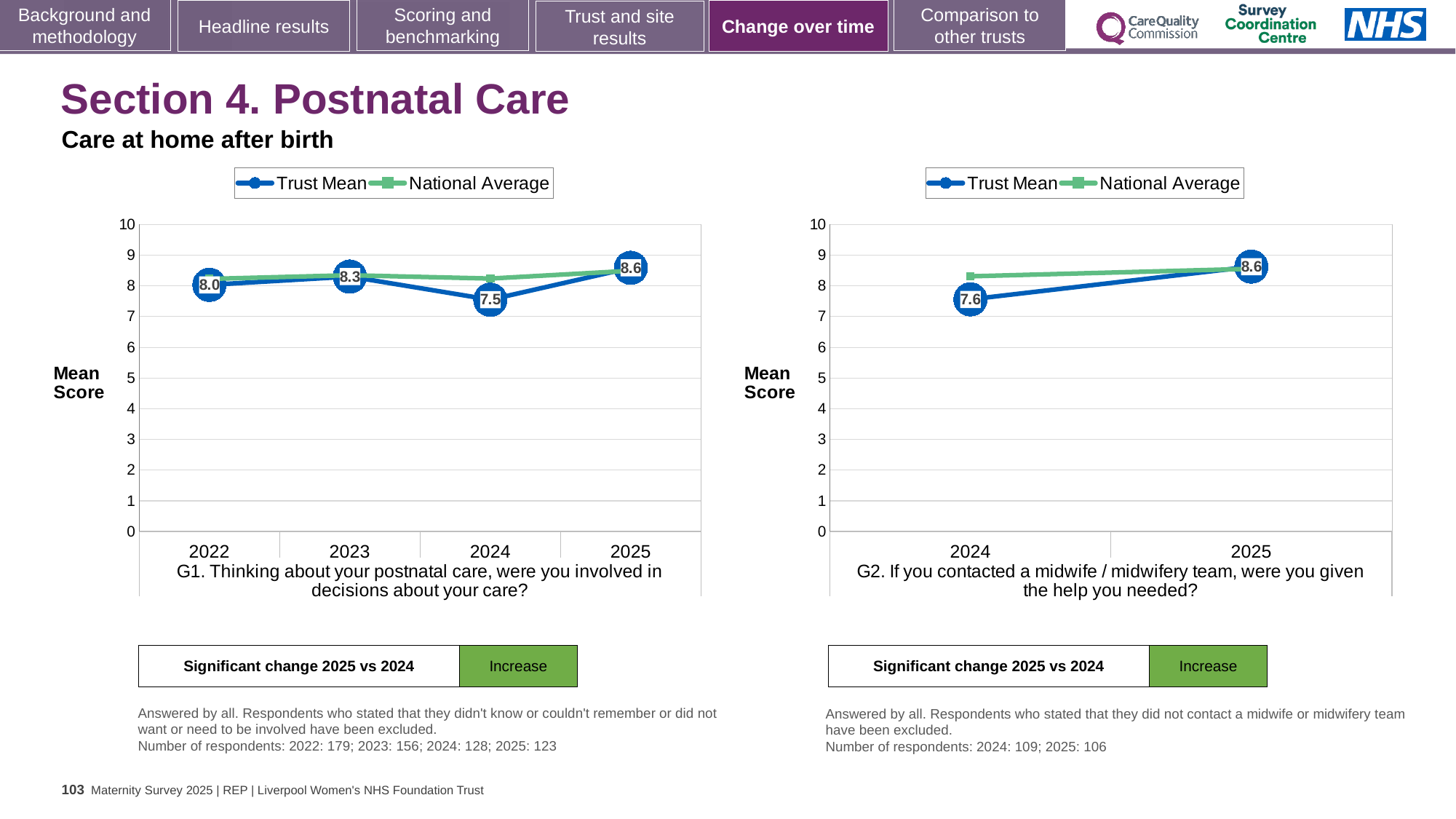
In the G1 chart (left), what is the Trust Mean for 2024? 7.5 How many years are plotted on the x axis of the G1 chart (left)? 4 In the G1 chart (left), is the Trust Mean higher in 2023 or in 2024? 2023 In the G2 chart (right), is the National Average for 2024 greater or less than 8? greater In the G2 chart (right), what is the Trust Mean for 2025? 8.6 In the G1 chart (left), which year has the highest Trust Mean? 2025 In the G1 chart (left), what is the Trust Mean for 2022? 8.0 What type of chart is the G2 chart (right)? Line chart How many series does the legend of the G2 chart (right) list? 2 In the G1 chart (left), what is the difference between the Trust Mean for 2023 and 2024? 0.8 In the G2 chart (right), what is the difference between the Trust Mean for 2025 and 2024? 1.0 In the G1 chart (left), which year has the lowest Trust Mean? 2024